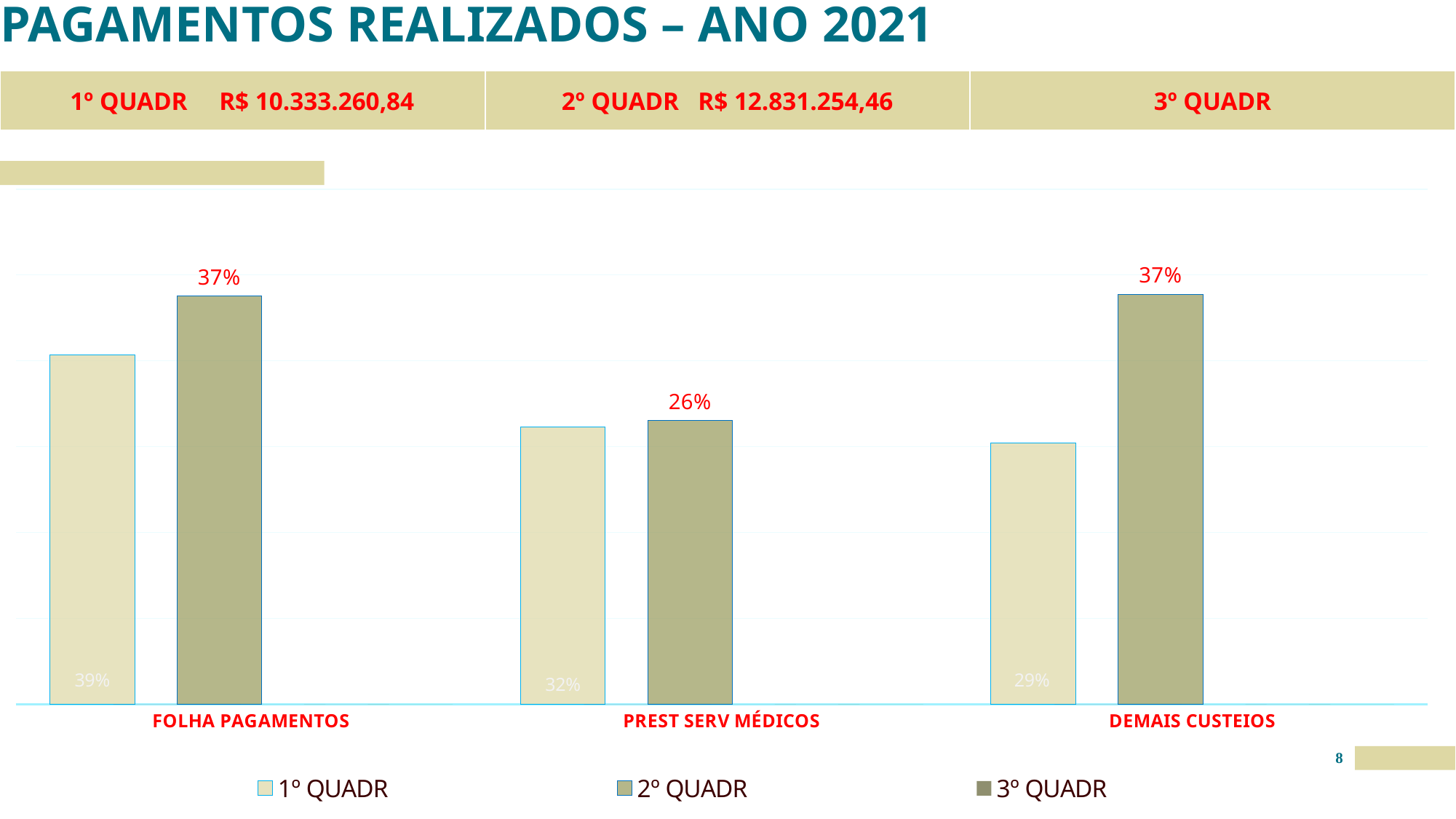
For DEMAIS CUSTEIOS, which is larger: the 1º QUADR value or the 2º QUADR value? 2º QUADR Which category has the highest 1º QUADR value? FOLHA PAGAMENTOS What is the 1º QUADR value for FOLHA PAGAMENTOS? 39% Which category has the lowest 2º QUADR value? PREST SERV MÉDICOS Do the 1º QUADR values rise or fall from FOLHA PAGAMENTOS to DEMAIS CUSTEIOS? fall How many series does the chart legend list? 3 How many categories are shown on the x axis of the chart? 3 What is the 2º QUADR value for DEMAIS CUSTEIOS? 37% What is the 1º QUADR value for DEMAIS CUSTEIOS? 29% What is the difference between the 1º QUADR and 2º QUADR values for PREST SERV MÉDICOS? 6% What is the 2º QUADR value for PREST SERV MÉDICOS? 26% What kind of chart is shown on the slide? bar chart